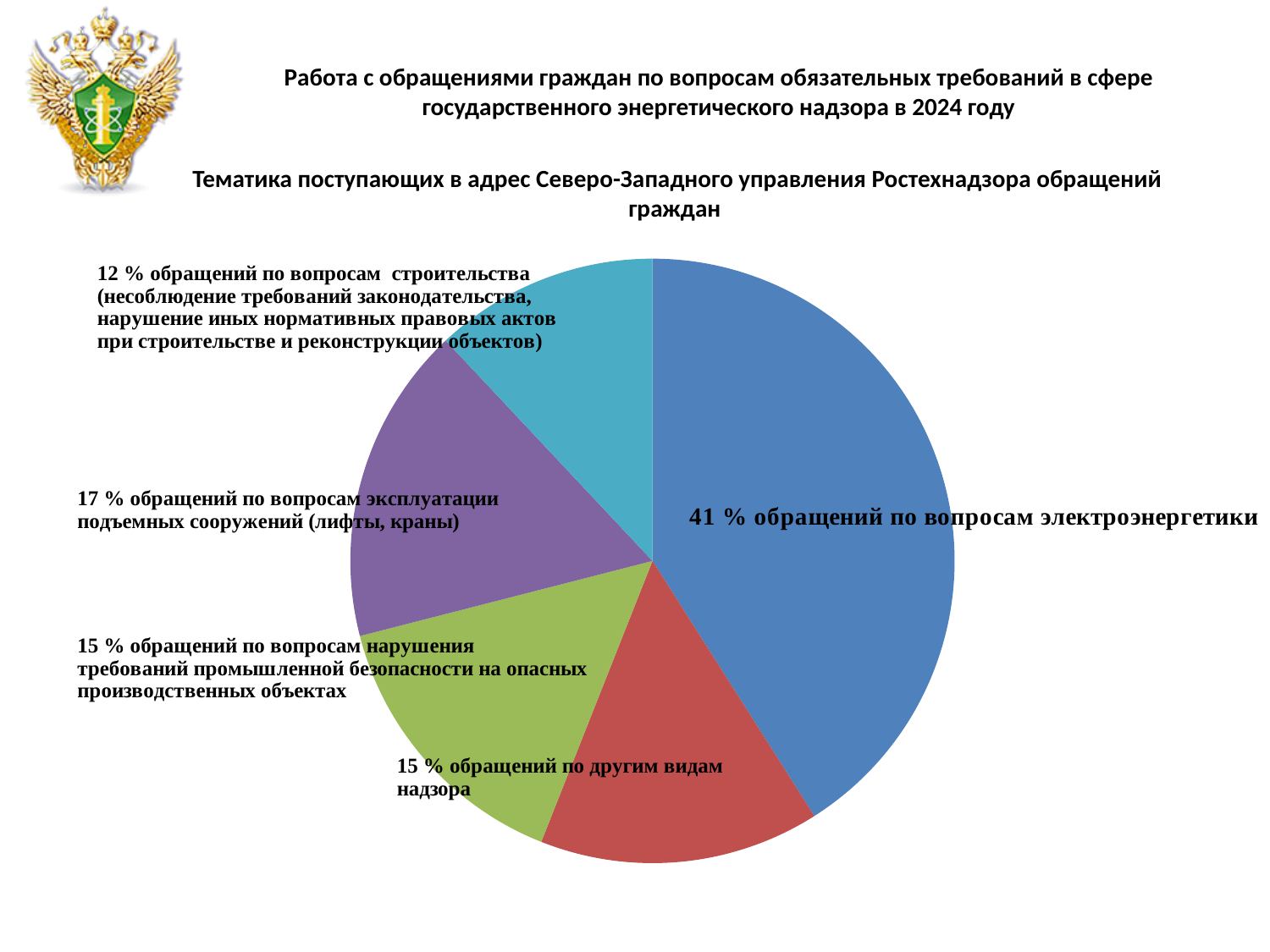
What share of appeals concerns other types of supervision (другие виды надзора)? 15 % Which topic accounts for the largest share of appeals? обращения по вопросам электроэнергетики How many slices does the pie chart have? 5 What share of appeals concerns electric power issues (вопросы электроэнергетики)? 41 % What share of appeals concerns the operation of lifting structures (lifts, cranes)? 17 % Which is larger: the share of appeals about lifting structures or the share about industrial safety at hazardous production facilities? lifting structures (17 %) What colour is the slice representing appeals on electric power issues? blue Which topic accounts for the smallest share of appeals? обращения по вопросам строительства What share of appeals concerns violations of industrial safety requirements at hazardous production facilities? 15 % What share of appeals concerns construction issues? 12 % What kind of chart is shown on the slide? pie chart By how many percentage points does the share of electric power appeals exceed the share of construction appeals? 29